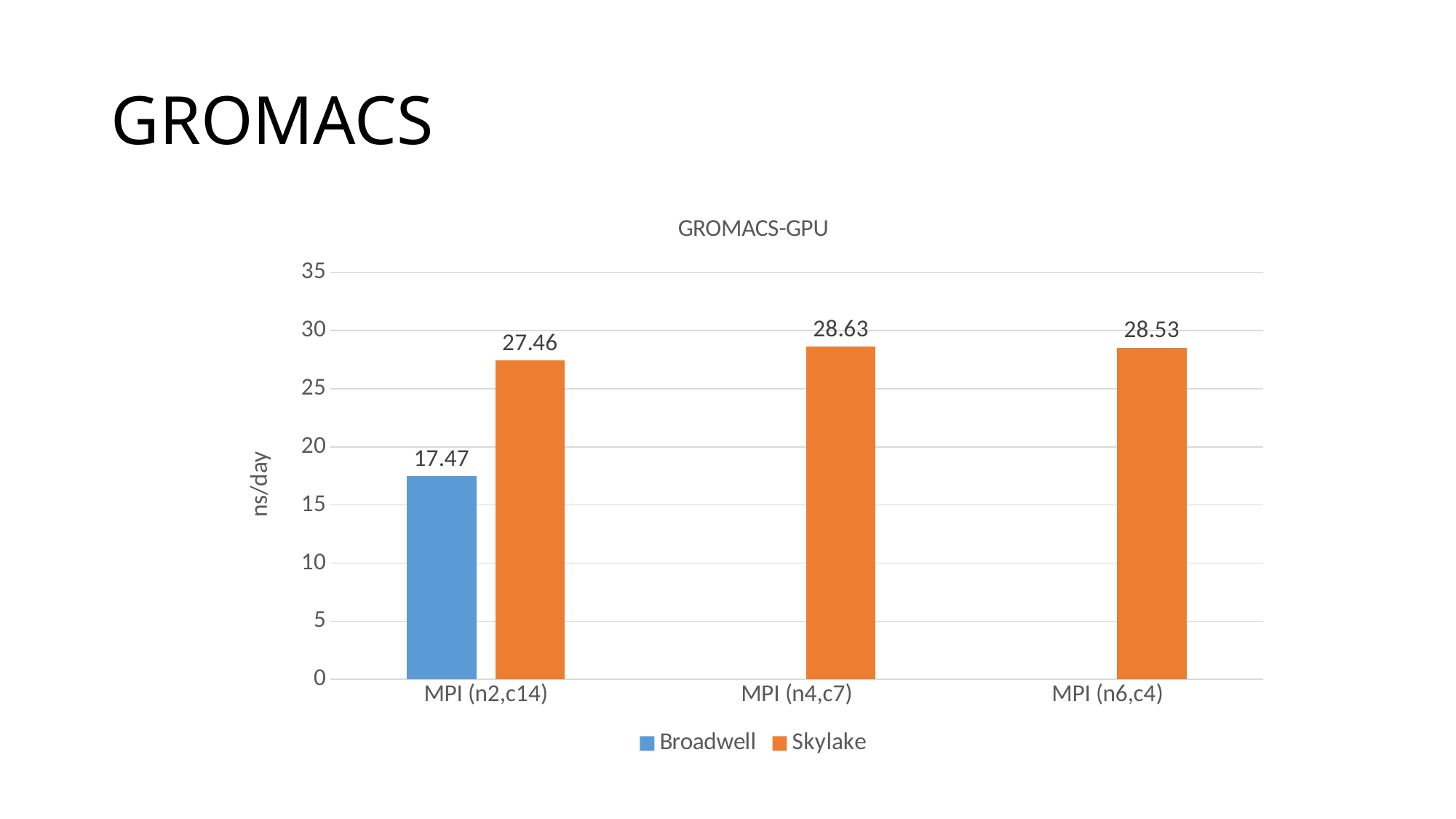
Which category has the highest Skylake value? MPI (n4,c7) What is the Skylake value for MPI (n2,c14)? 27.46 What is the Skylake value for MPI (n4,c7)? 28.63 What is the Skylake value for MPI (n6,c4)? 28.53 What is the Broadwell value for MPI (n2,c14)? 17.47 Which category has the lowest Skylake value? MPI (n2,c14) What is the title of the chart? GROMACS-GPU What kind of chart is shown? bar chart What is the difference between the Skylake and Broadwell values for MPI (n2,c14)? 9.99 For MPI (n2,c14), which series has the larger value, Broadwell or Skylake? Skylake How many series does the legend list? 2 How many categories are shown on the x axis? 3